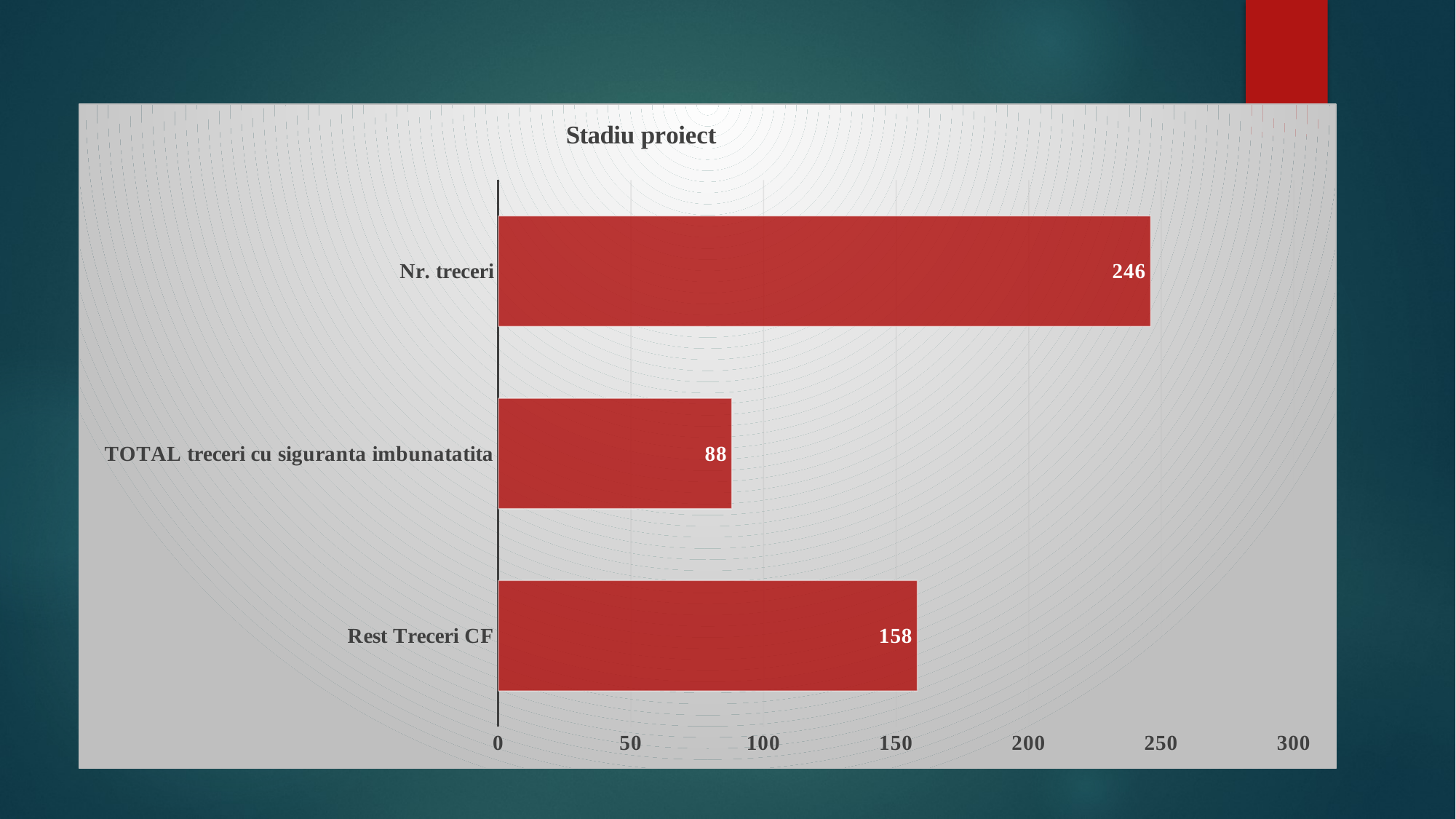
How many categories are shown in the chart? 3 What is the difference between the values for Rest Treceri CF and TOTAL treceri cu siguranta imbunatatita? 70 What is the difference between the values for Nr. treceri and Rest Treceri CF? 88 What is the value for TOTAL treceri cu siguranta imbunatatita? 88 Which category has the lowest value? TOTAL treceri cu siguranta imbunatatita Which is larger, the value for Rest Treceri CF or the value for TOTAL treceri cu siguranta imbunatatita? Rest Treceri CF What is the value for Rest Treceri CF? 158 What is the value for Nr. treceri? 246 What is the title of the chart? Stadiu proiect Is the value for Nr. treceri greater or less than 200? greater What kind of chart is shown on the slide? bar chart Which category has the highest value? Nr. treceri